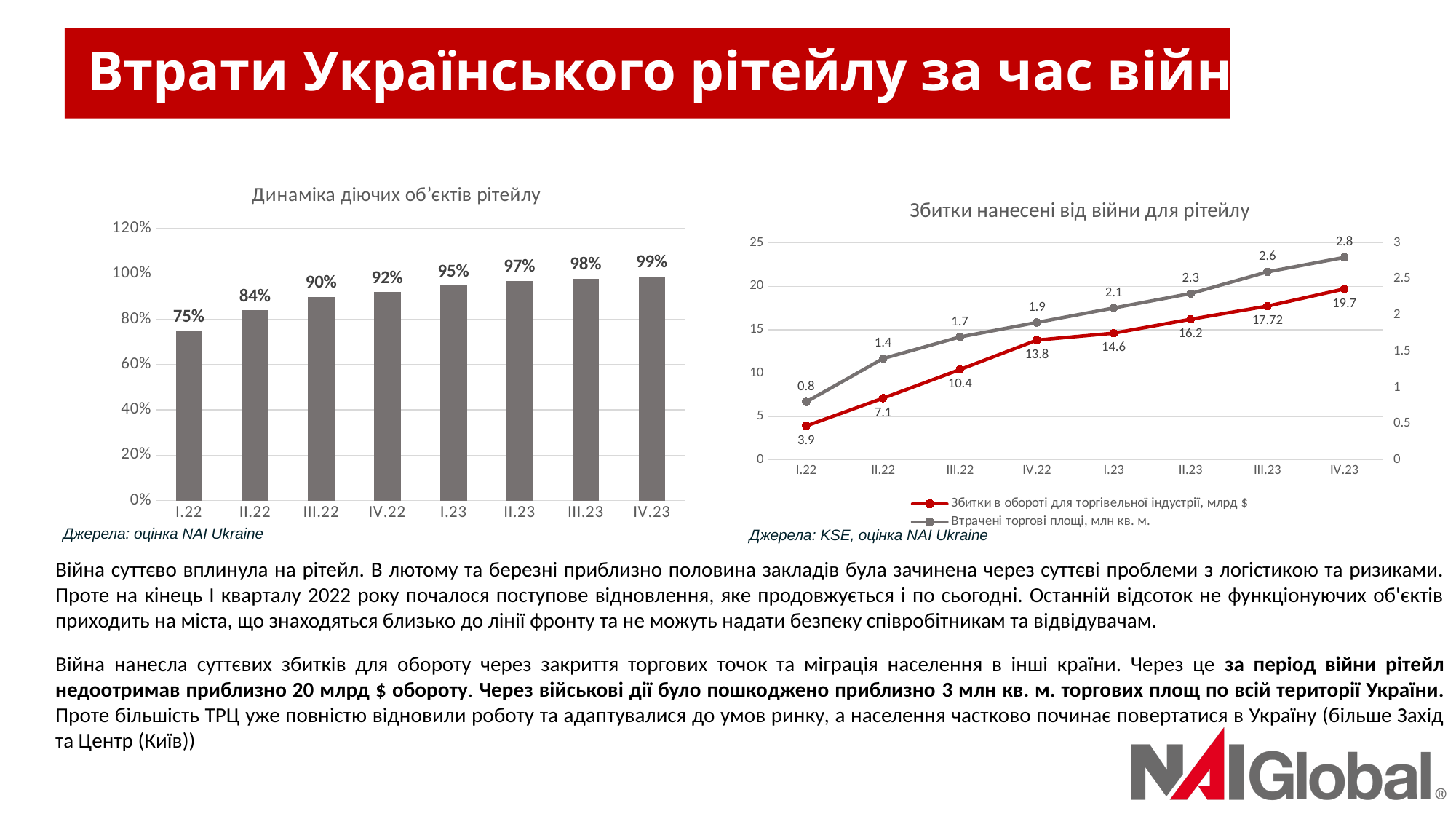
In the chart 'Динаміка діючих об'єктів рітейлу', which quarter has the lowest value? I.22 In the chart 'Збитки нанесені від війни для рітейлу', what is the value of 'Втрачені торгові площі, млн кв. м.' for II.22? 1.4 In the chart 'Динаміка діючих об'єктів рітейлу', how many quarters are shown on the x axis? 8 In the chart 'Динаміка діючих об'єктів рітейлу', what is the difference between the values for IV.23 and I.22? 24% In the chart 'Динаміка діючих об'єктів рітейлу', what is the value for IV.22? 92% In the chart 'Збитки нанесені від війни для рітейлу', which colour is the line for 'Втрачені торгові площі, млн кв. м.'? Grey In the chart 'Збитки нанесені від війни для рітейлу', what is the value of 'Збитки в обороті для торгівельної індустрії, млрд $' for III.23? 17.72 In the chart 'Збитки нанесені від війни для рітейлу', how many series does the legend list? 2 In the chart 'Динаміка діючих об'єктів рітейлу', what is the value for I.22? 75% What type of chart is 'Динаміка діючих об'єктів рітейлу'? Bar chart In the chart 'Збитки нанесені від війни для рітейлу', what is the difference between the 'Збитки в обороті' values for IV.23 and I.22? 15.8 In the chart 'Динаміка діючих об'єктів рітейлу', do the values rise or fall from I.22 to IV.23? Rise